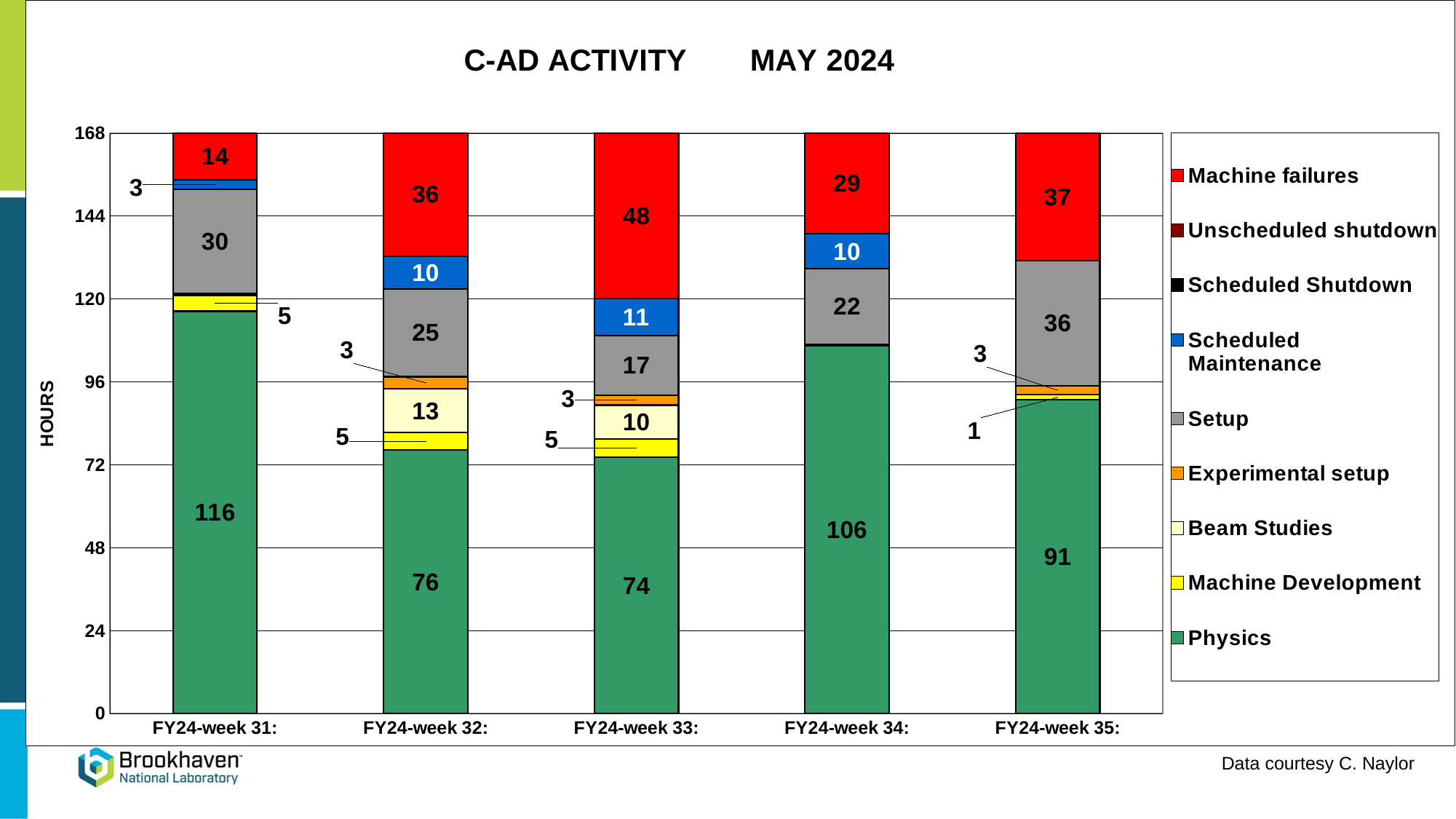
Which week has the highest Machine failures value? FY24-week 33 How many hours of Physics are shown for FY24-week 31? 116 What is the Setup value for FY24-week 35? 36 What is the Machine failures value for FY24-week 33? 48 How many series does the legend list? 9 Which has a larger Setup value, FY24-week 31 or FY24-week 32? FY24-week 31 Which week has the lowest Physics value? FY24-week 33 What kind of chart is shown on the slide? Stacked bar chart What is the Beam Studies value for FY24-week 32? 13 How many weeks are shown on the x axis? 5 Which week has the highest Physics value? FY24-week 31 What is the difference between the Machine failures values for FY24-week 33 and FY24-week 31? 34